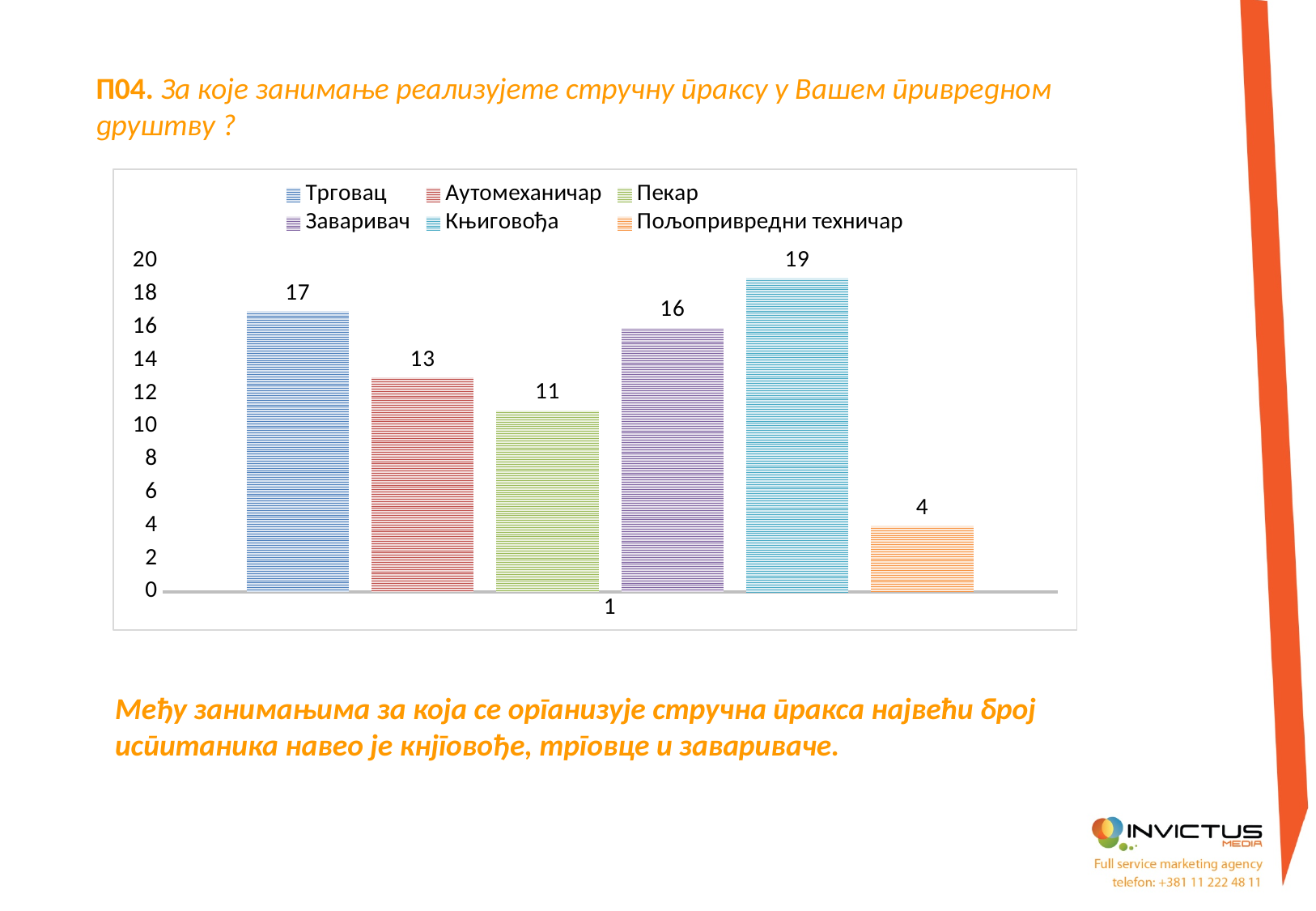
Which series has the highest value? Књиговођа What is the value for Књиговођа? 19 Is the value for Пекар greater or less than 10? greater How many series does the legend list? 6 What is the difference between the values for Књиговођа and Пекар? 8 What is the value for Трговац? 17 What is the difference between the values for Трговац and Аутомеханичар? 4 Which is larger, the value for Аутомеханичар or the value for Заваривач? Заваривач What kind of chart is shown on the slide? bar chart Which series has the lowest value? Пољопривредни техничар What is the value for Пољопривредни техничар? 4 What colour is the bar for Заваривач? purple